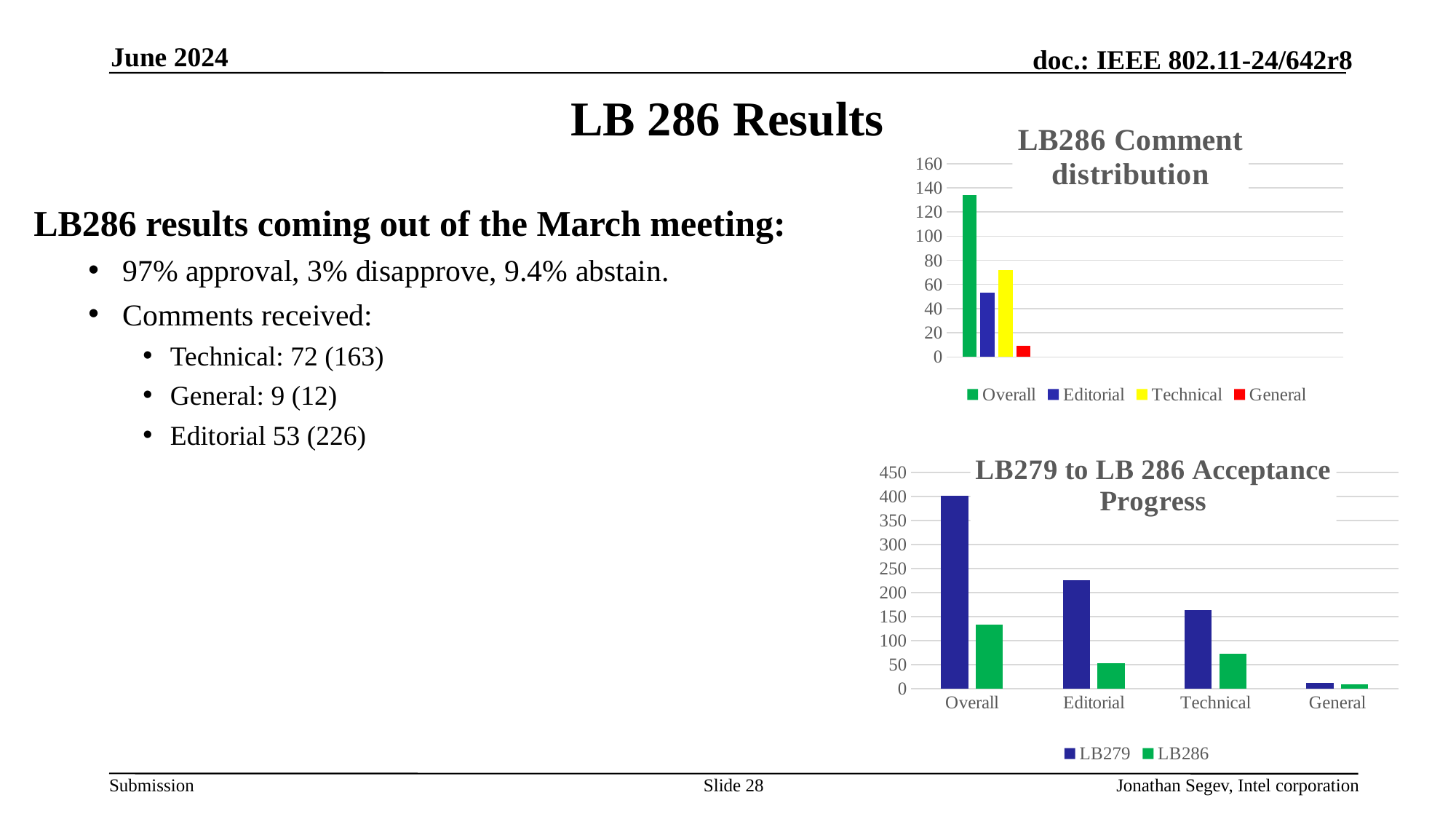
How many categories are shown on the x axis of the LB279 to LB 286 Acceptance Progress chart? 4 What colour is the Technical bar in the LB286 Comment distribution chart? Yellow In the LB286 Comment distribution chart, is the value for Overall greater or less than 120? greater In the LB279 to LB 286 Acceptance Progress chart, which is larger for Editorial, LB279 or LB286? LB279 In the LB286 Comment distribution chart, which series has the shortest bar? General What kind of chart is the LB279 to LB 286 Acceptance Progress chart? Bar chart In the LB286 Comment distribution chart, which series has the tallest bar? Overall In the LB279 to LB 286 Acceptance Progress chart, is the LB279 value for Overall greater or less than 350? greater In the LB279 to LB 286 Acceptance Progress chart, which category has the lowest LB279 value? General How many series does the legend of the LB286 Comment distribution chart list? 4 In the LB286 Comment distribution chart, is the value for Technical greater or less than 80? less In the LB286 Comment distribution chart, which is larger, Editorial or Technical? Technical